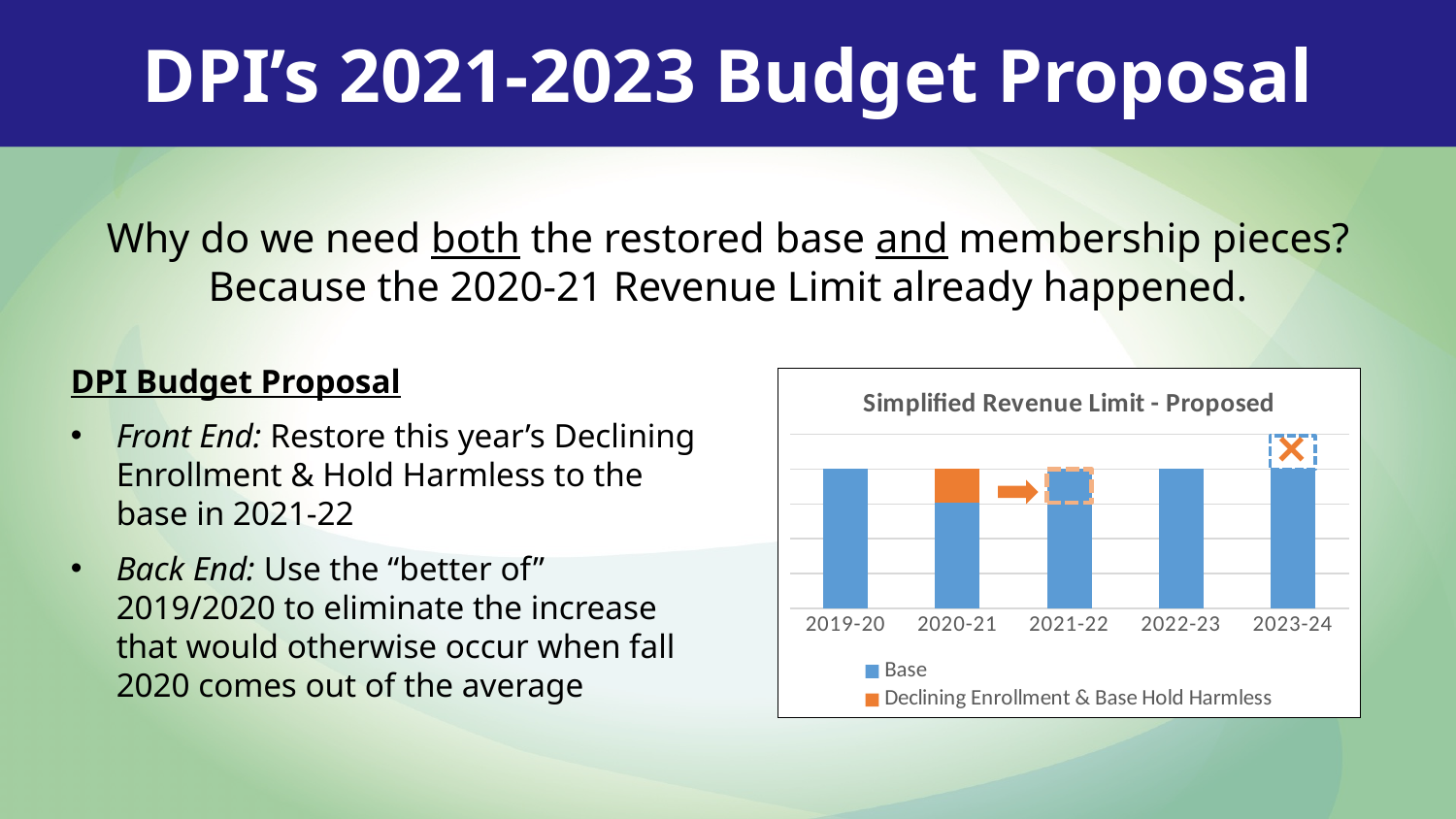
Which year in the chart has a dashed box with an X drawn above its bar? 2023-24 Which series is shown in orange in the chart? Declining Enrollment & Base Hold Harmless How many school-year categories are shown on the x axis of the chart? 5 What kind of chart is shown on the slide? bar chart Is the Base value for 2021-22 larger or smaller than the Base value for 2020-21? Neither; they are equal Which year in the chart has a solid orange Declining Enrollment & Base Hold Harmless segment stacked on its bar? 2020-21 What is the title of the chart? Simplified Revenue Limit - Proposed Is the Base value for 2019-20 larger or smaller than the Base value for 2020-21? larger How many series does the chart legend list? 2